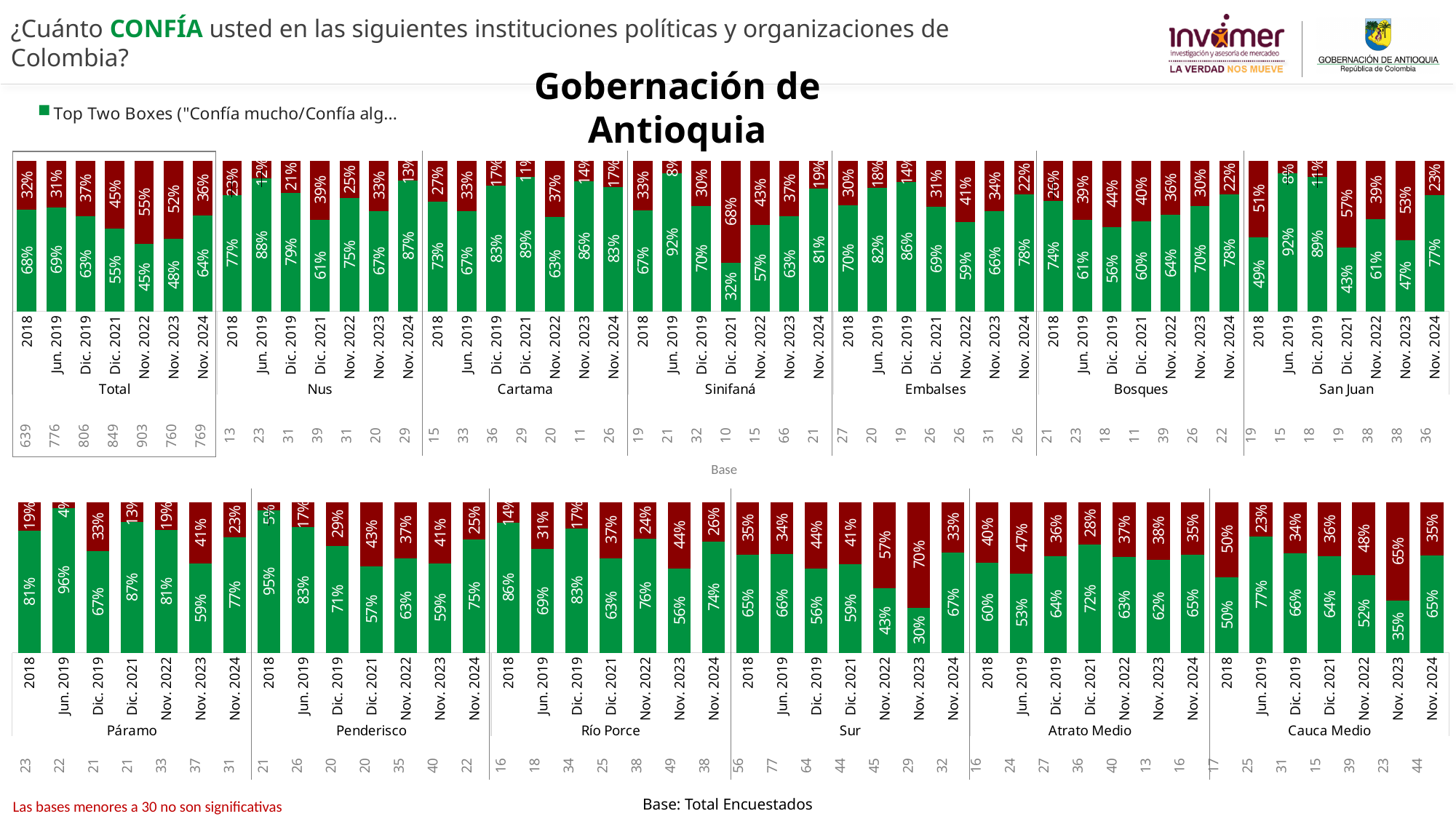
In the top chart, what is the green Top Two Boxes value for Total in Nov. 2024? 64% In the top chart, which year has the lowest green value within the Total group? Nov. 2022 In the bottom chart, what is the green value for Sur in Nov. 2023? 30% How many bars are shown for the Total group in the top chart? 7 In the bottom chart, which year has the highest green value within the Páramo group? Jun. 2019 In the top chart, what is the difference between the green values for Total in 2018 and Nov. 2022? 23% What type of chart is used on this slide? Stacked bar chart In the top chart, what is the green value for Sinifaná in Dic. 2021? 32% In the top chart, what is the total of the green and red segments for the Nus 2018 bar? 100% In the top chart, does the green value for Total rise or fall from Dic. 2019 to Nov. 2022? Fall In the bottom chart, which is larger: the green value for Cauca Medio in Jun. 2019 or in Nov. 2023? Jun. 2019 What is the title shown above the charts? Gobernación de Antioquia